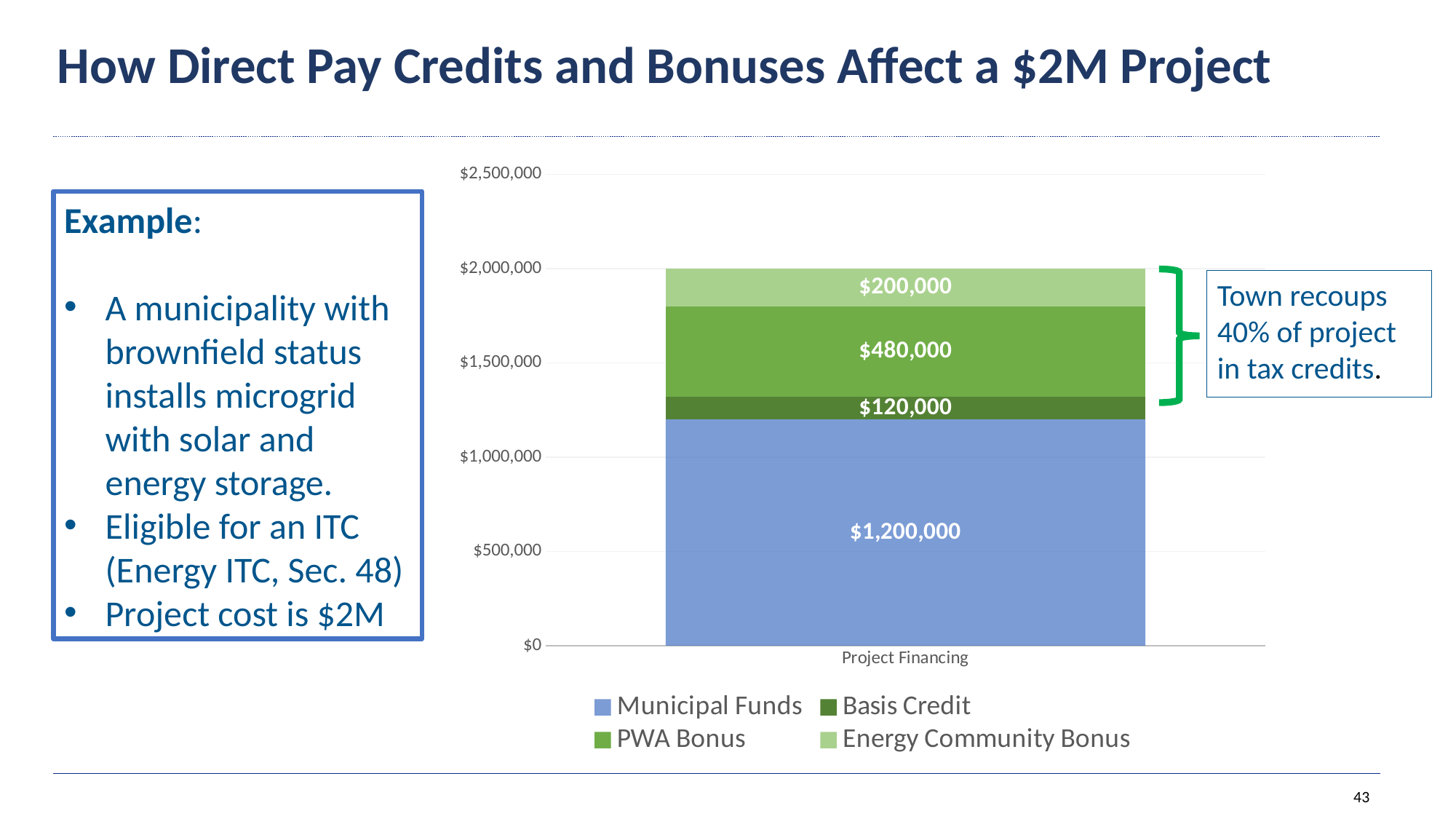
What is the category label on the x axis of the chart? Project Financing What kind of chart is shown on the slide? Stacked bar chart What is the value of the Municipal Funds segment in the Project Financing bar? $1,200,000 What is the difference between the PWA Bonus and the Energy Community Bonus segments? $280,000 Which is larger, the PWA Bonus segment or the Basis Credit segment? PWA Bonus Which series has the largest segment in the Project Financing bar? Municipal Funds What is the total of the stacked Project Financing bar? $2,000,000 How many series does the legend list? 4 What is the value of the PWA Bonus segment in the Project Financing bar? $480,000 What is the value of the Basis Credit segment in the Project Financing bar? $120,000 Which series has the smallest segment in the Project Financing bar? Basis Credit What is the value of the Energy Community Bonus segment in the Project Financing bar? $200,000